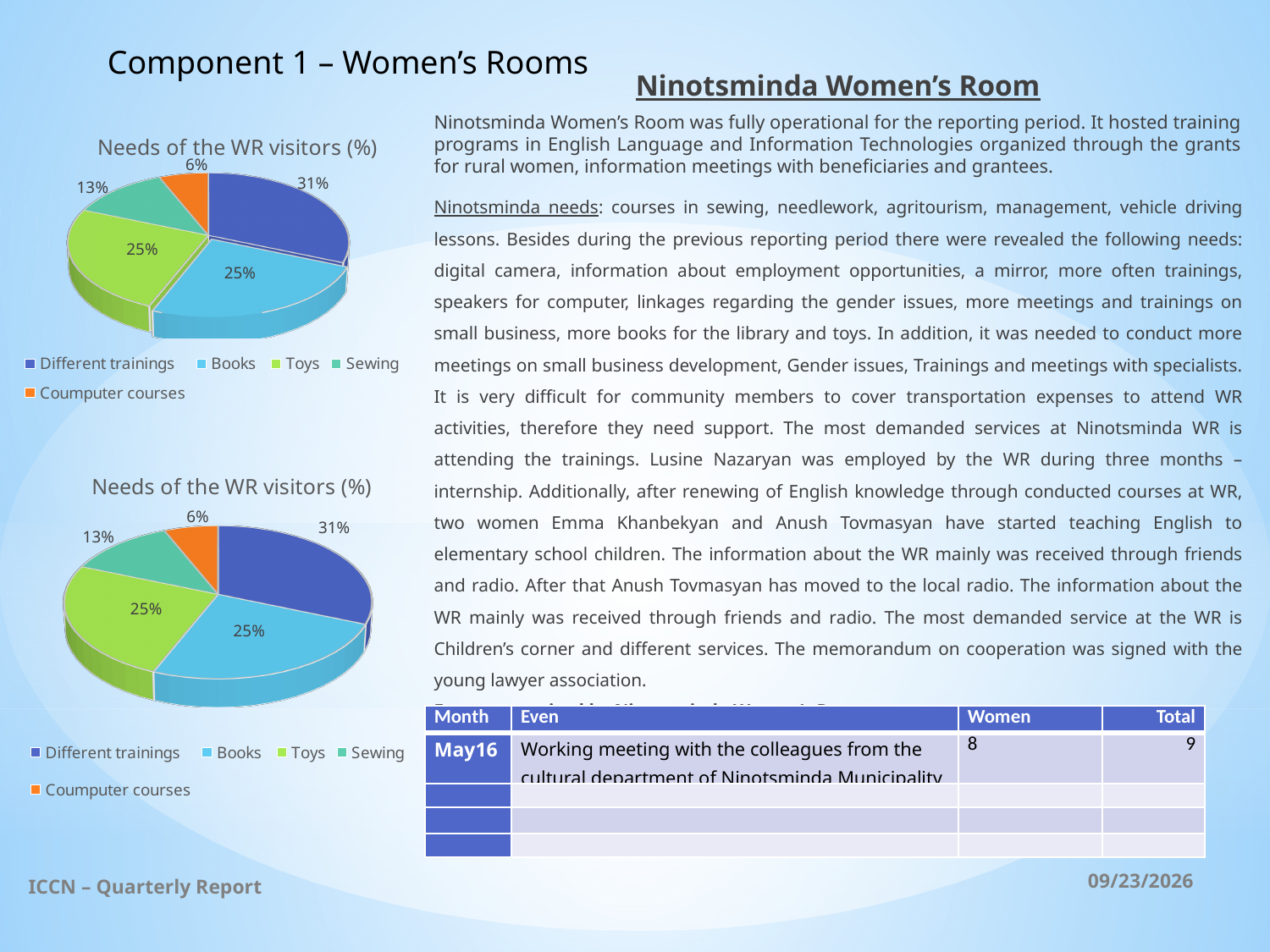
In the bottom pie chart, what percentage is shown for Books? 25% What is the title of the top chart? Needs of the WR visitors (%) In the bottom pie chart, what percentage is shown for Coumputer courses? 6% How many categories does the legend of the top pie chart list? 5 In the bottom pie chart, what is the combined percentage of Books and Toys? 50% In the top pie chart, what percentage is shown for Different trainings? 31% What type of chart is the bottom chart on the slide? Pie chart In the bottom pie chart, which category has the smallest share? Coumputer courses In the bottom pie chart, which is larger, the share for Sewing or the share for Coumputer courses? Sewing In the top pie chart, which category has the largest share? Different trainings In the top pie chart, what is the difference in percentage points between Different trainings and Sewing? 18 In the top pie chart, what percentage is shown for Sewing? 13%